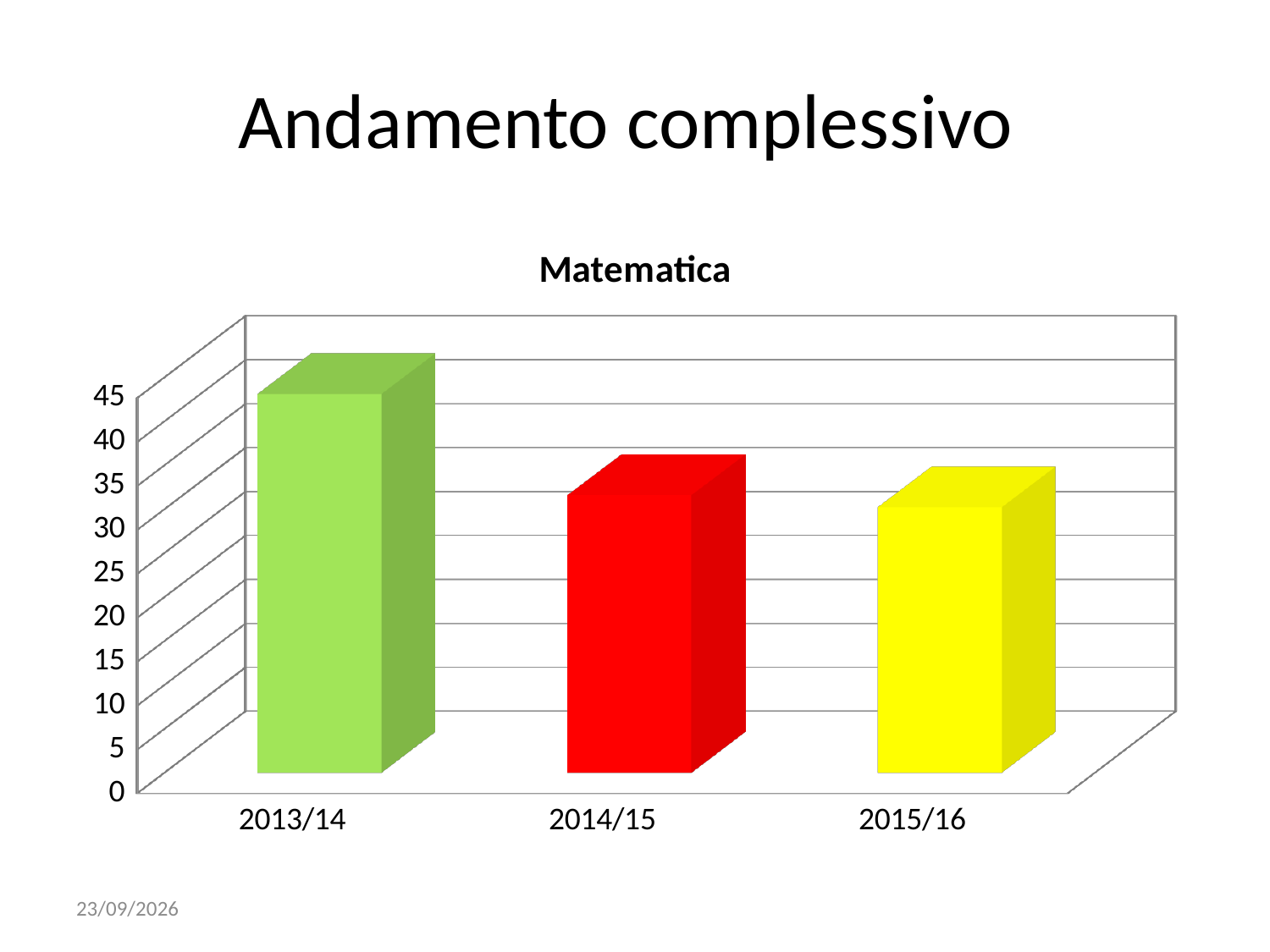
Which is larger, the value for 2013/14 or the value for 2015/16? 2013/14 Is the value for 2015/16 greater or less than 20? greater How many categories are shown on the x axis of the chart? 3 What colour is the bar for 2014/15? red What type of chart is shown on the slide? bar chart Is the value for 2013/14 greater or less than 30? greater What is the title of the chart? Matematica Is the value for 2014/15 greater or less than 40? less Do the values rise or fall from 2013/14 to 2015/16? fall Which school year has the highest value in the chart? 2013/14